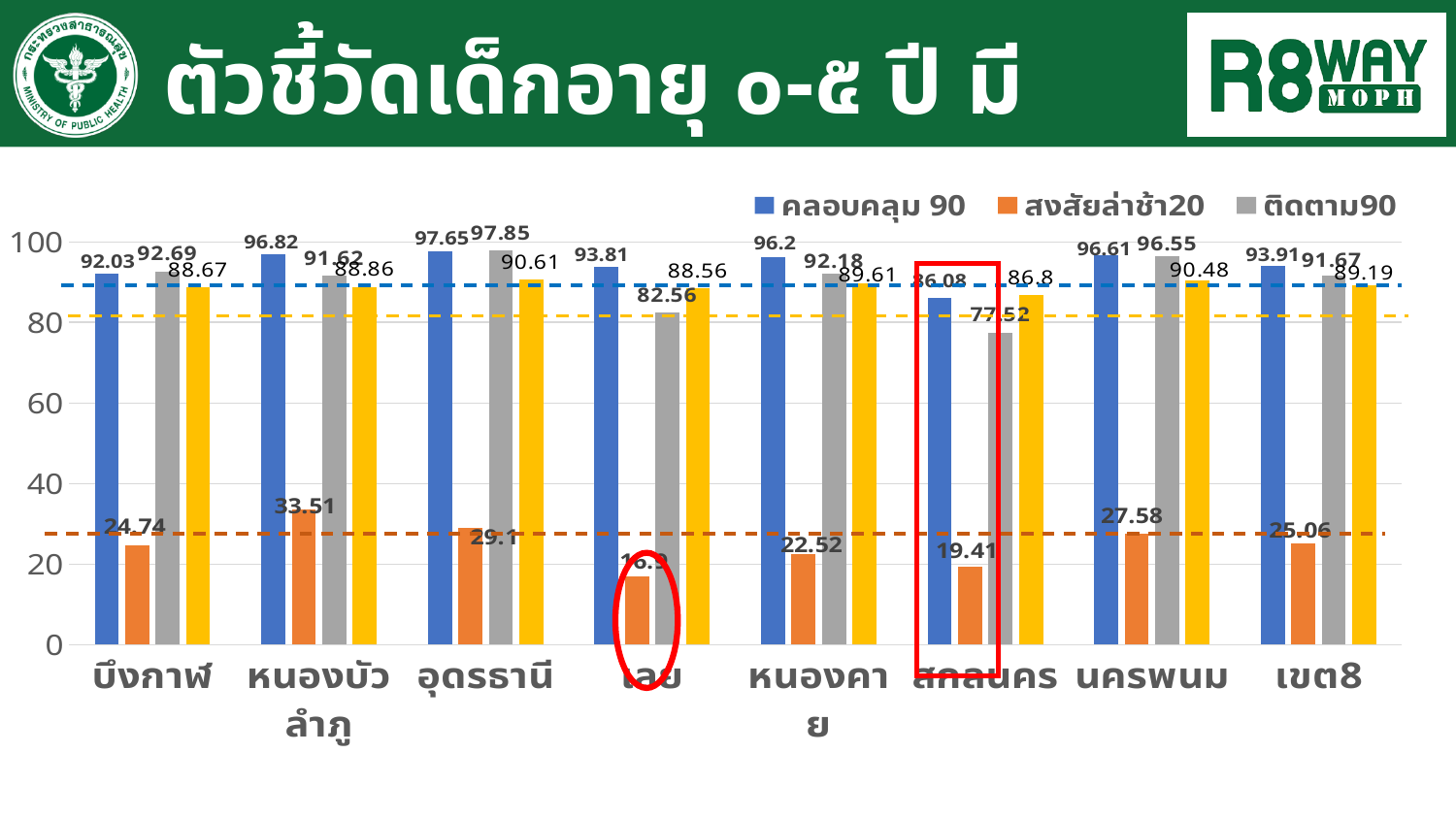
Is the ติดตาม90 value for สกลนคร greater or less than 80? less What is the value of คลอบคลุม 90 for สกลนคร? 86.08 What is the value of ติดตาม90 for เขต8? 91.67 Which is larger, the ติดตาม90 value for เลย or for สกลนคร? เลย Which category has the highest value for คลอบคลุม 90? อุดรธานี Which category has the lowest value for ติดตาม90? สกลนคร What is the value of สงสัยล่าช้า20 for หนองบัวลำภู? 33.51 What kind of chart is shown on the slide? bar chart Which category has the highest value for สงสัยล่าช้า20? หนองบัวลำภู How many categories are shown on the x axis? 8 What is the difference between the คลอบคลุม 90 values for อุดรธานี and สกลนคร? 11.57 What is the value of ติดตาม90 for อุดรธานี? 97.85